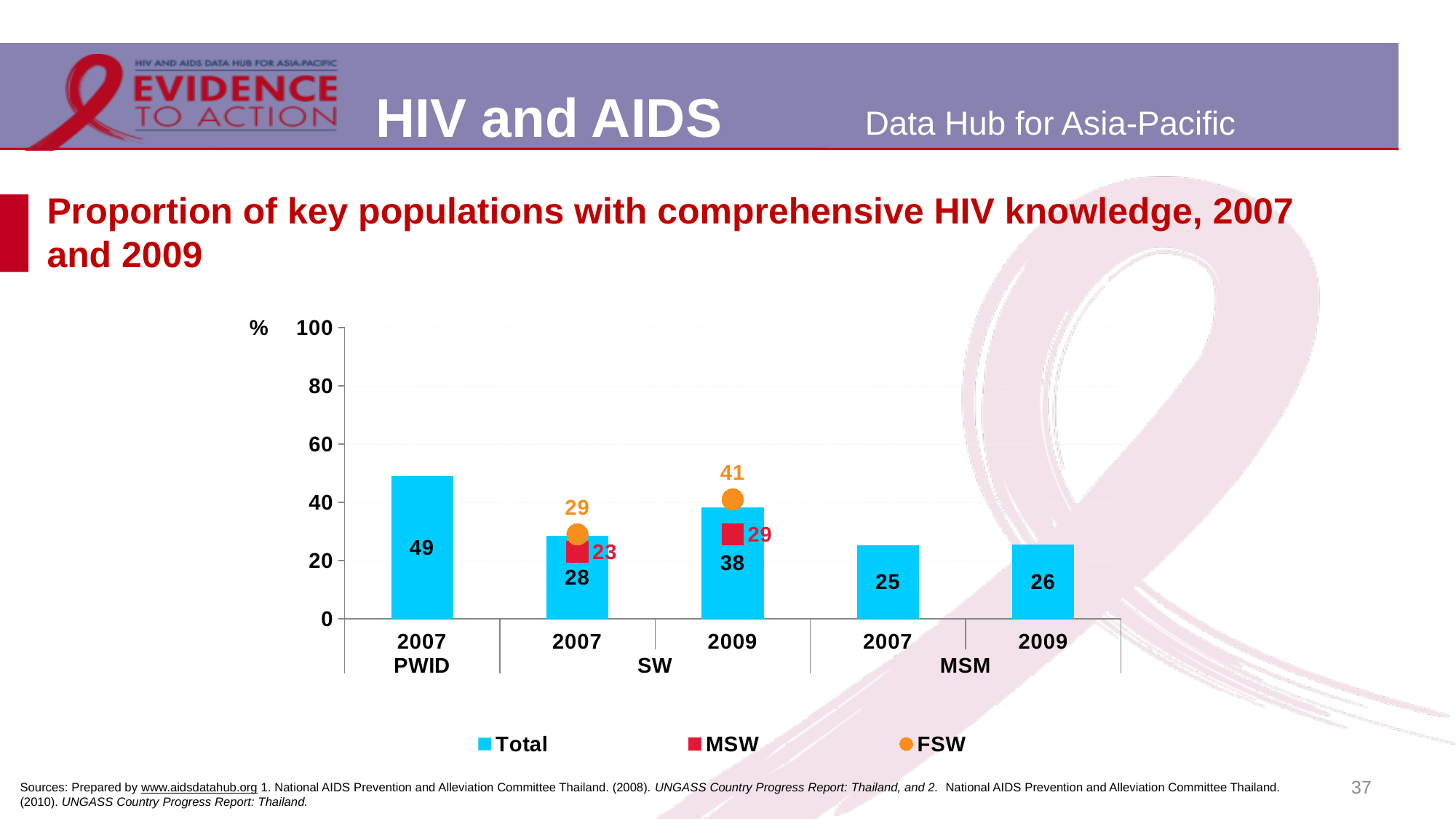
What kind of chart is shown on the slide? Bar chart Which category has the highest Total value? 2007 PWID What is the difference between the FSW and MSW values for SW in 2009? 12 How many Total bars are plotted in the chart? 5 Which is larger, the FSW value for SW in 2007 or the MSW value for SW in 2007? FSW What is the MSW value for SW in 2007? 23 What is the Total value for PWID in 2007? 49 What is the FSW value for SW in 2009? 41 Which category has the lowest Total value? 2007 MSM What is the Total value for SW in 2009? 38 What is the difference between the Total values for SW in 2009 and SW in 2007? 10 How many series does the legend list? 3